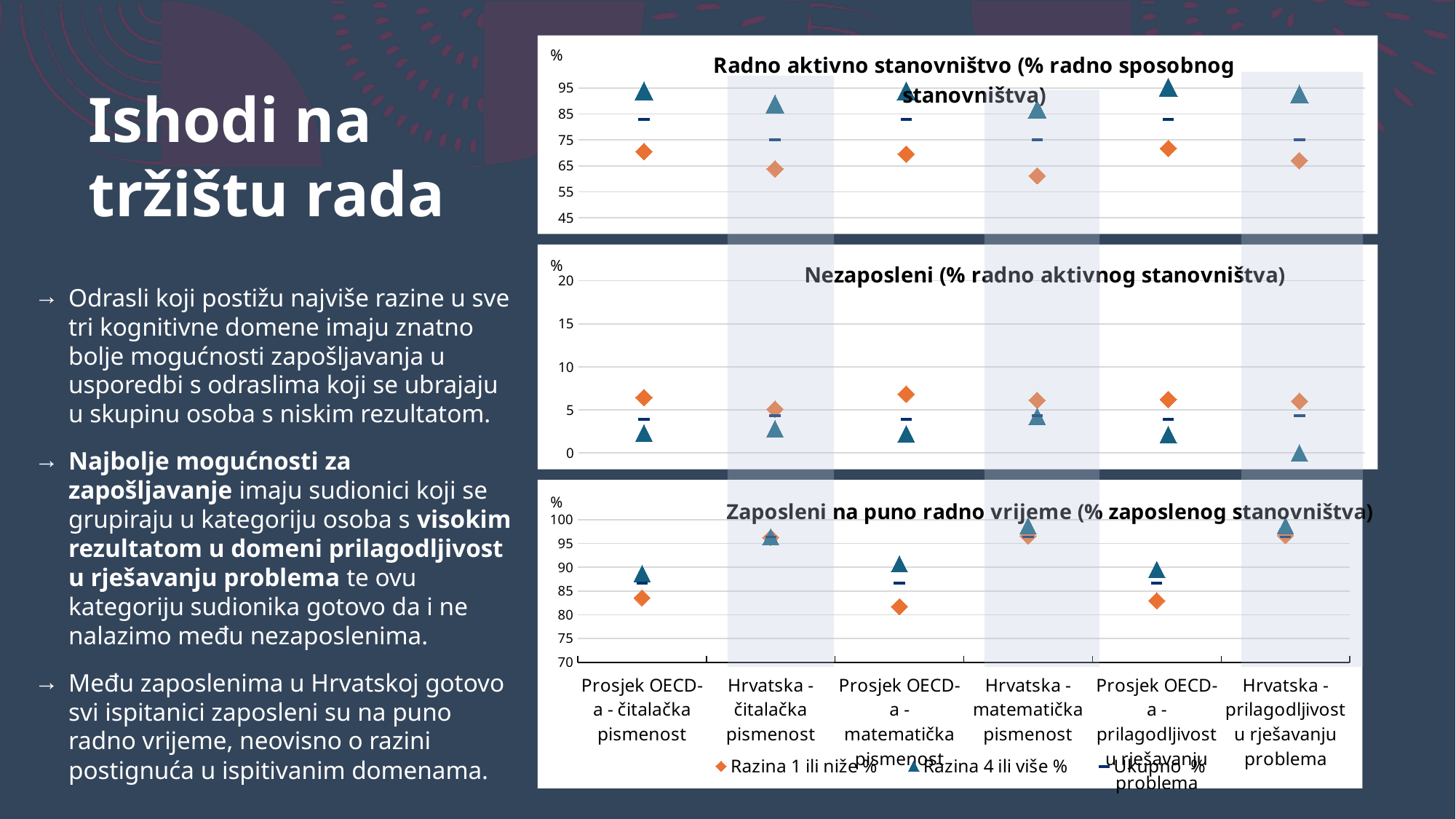
In the middle chart (Nezaposleni), for Hrvatska - prilagodljivost u rješavanju problema, which series has the larger value: Razina 1 ili niže % or Razina 4 ili više %? Razina 1 ili niže % Which legend entry is shown with an orange diamond marker? Razina 1 ili niže % In the middle chart (Nezaposleni), is the value of Razina 4 ili više % for Hrvatska - prilagodljivost u rješavanju problema greater or less than 5? less In the top chart (Radno aktivno stanovništvo), is the value of Razina 1 ili niže % for Hrvatska - matematička pismenost greater or less than 65? less In the top chart (Radno aktivno stanovništvo), is the value of Razina 4 ili više % for Prosjek OECD-a - čitalačka pismenost greater or less than 85? greater How many series does the legend at the bottom of the slide list? 3 In the top chart (Radno aktivno stanovništvo), for Prosjek OECD-a - čitalačka pismenost, which series has the larger value: Razina 1 ili niže % or Razina 4 ili više %? Razina 4 ili više % What is the title of the middle chart? Nezaposleni (% radno aktivnog stanovništva) In the top chart (Radno aktivno stanovništvo), how many categories are shown on the x axis? 6 In the bottom chart (Zaposleni na puno radno vrijeme), for the series Razina 1 ili niže %, which category has the larger value: Prosjek OECD-a - čitalačka pismenost or Hrvatska - čitalačka pismenost? Hrvatska - čitalačka pismenost